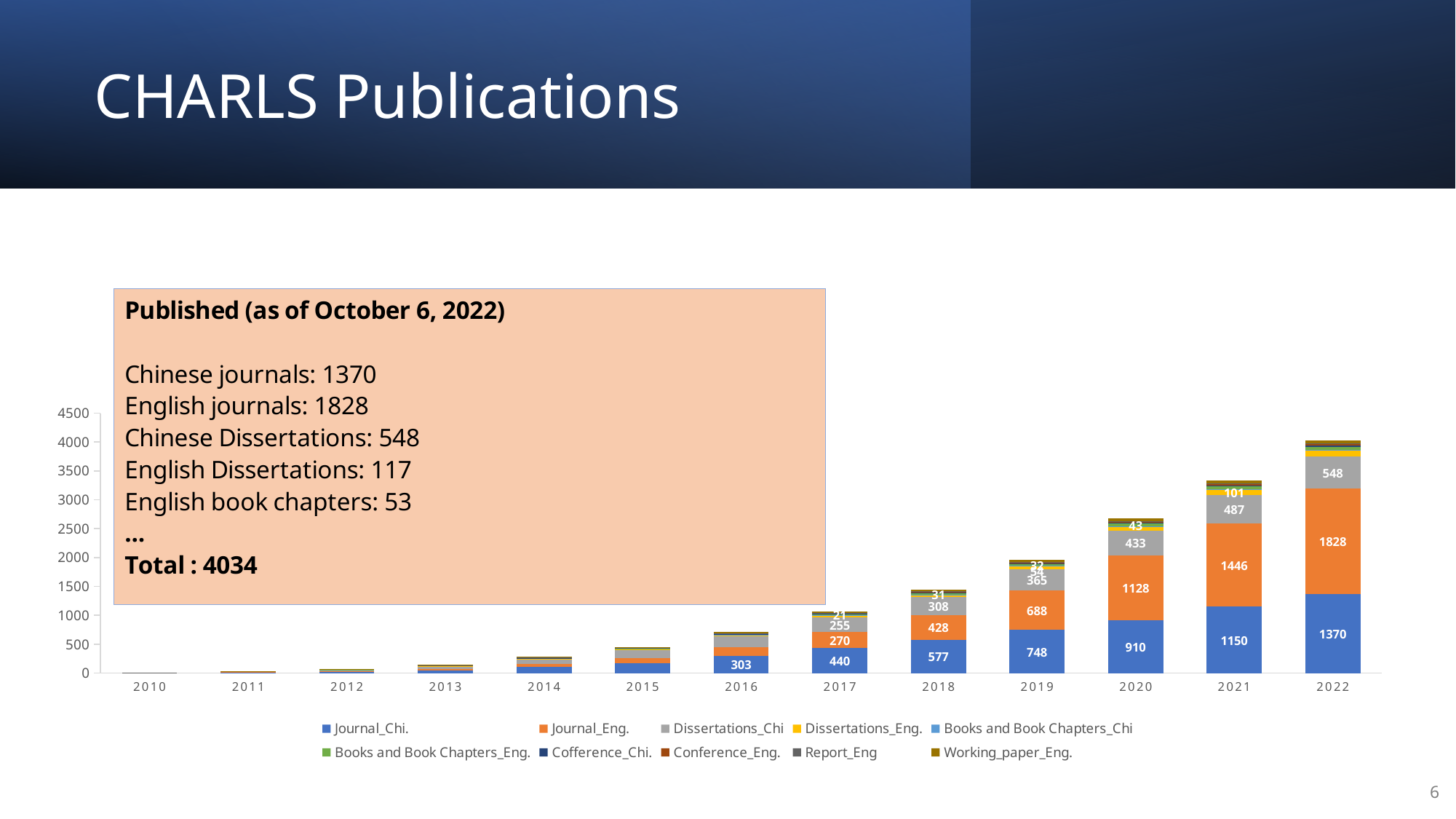
What is the difference between the Journal_Chi. values for 2021 and 2020? 240 Which year has the tallest stacked bar? 2022 In 2019, which is larger: the Journal_Chi. value or the Journal_Eng. value? Journal_Chi. What is the Journal_Eng. value for 2021? 1446 How many years are shown along the x axis of the chart? 13 Is the total height of the 2020 bar greater or less than 2500? greater What kind of chart is shown on the slide? Stacked bar chart How many series does the chart's legend list? 10 What is the Dissertations_Eng. value for 2021? 101 By how much did the Journal_Eng. value increase from 2021 to 2022? 382 What is the Dissertations_Chi value for 2020? 433 What is the Journal_Chi. value for 2022? 1370